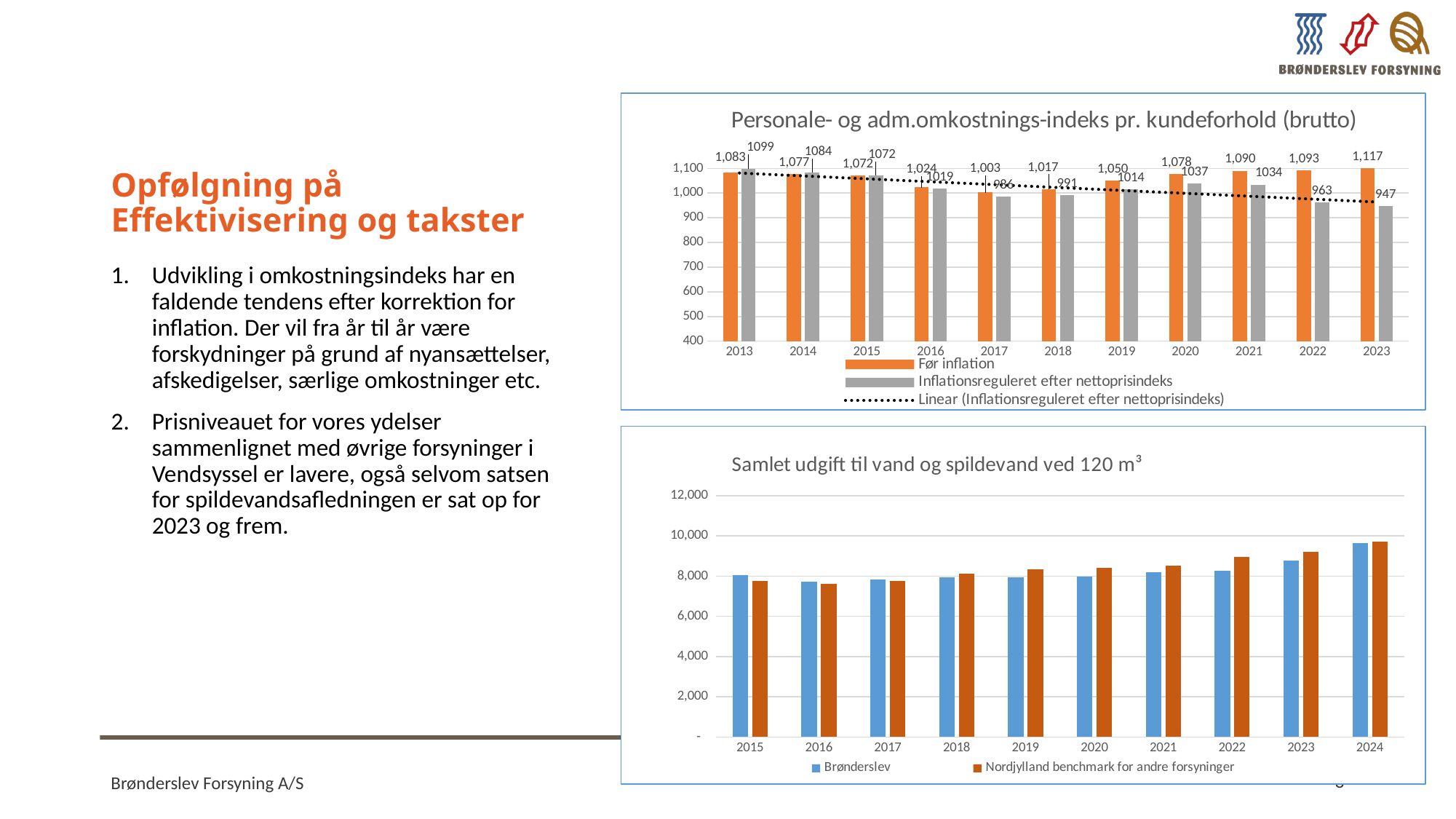
In the chart 'Samlet udgift til vand og spildevand ved 120 m³', is the value for Brønderslev in 2024 greater or less than 8,000? greater In the chart 'Personale- og adm.omkostnings-indeks pr. kundeforhold (brutto)', what is the difference between the 'Før inflation' and 'Inflationsreguleret efter nettoprisindeks' values for 2023? 170 What kind of chart is 'Samlet udgift til vand og spildevand ved 120 m³'? Bar chart In the chart 'Samlet udgift til vand og spildevand ved 120 m³', do the values for 'Nordjylland benchmark for andre forsyninger' rise or fall from 2016 to 2024? Rise In the chart 'Personale- og adm.omkostnings-indeks pr. kundeforhold (brutto)', which year has the lowest 'Inflationsreguleret efter nettoprisindeks' value? 2023 In the chart 'Personale- og adm.omkostnings-indeks pr. kundeforhold (brutto)', which year has the highest 'Før inflation' value? 2023 In the chart 'Personale- og adm.omkostnings-indeks pr. kundeforhold (brutto)', for 2013, which is larger: 'Før inflation' or 'Inflationsreguleret efter nettoprisindeks'? Inflationsreguleret efter nettoprisindeks In the chart 'Personale- og adm.omkostnings-indeks pr. kundeforhold (brutto)', what is the 'Før inflation' value for 2023? 1,117 How many entries does the legend of the chart 'Personale- og adm.omkostnings-indeks pr. kundeforhold (brutto)' list? 3 In the chart 'Personale- og adm.omkostnings-indeks pr. kundeforhold (brutto)', what is the 'Inflationsreguleret efter nettoprisindeks' value for 2017? 986 How many years are shown on the x axis of the chart 'Personale- og adm.omkostnings-indeks pr. kundeforhold (brutto)'? 11 How many years are shown on the x axis of the chart 'Samlet udgift til vand og spildevand ved 120 m³'? 10